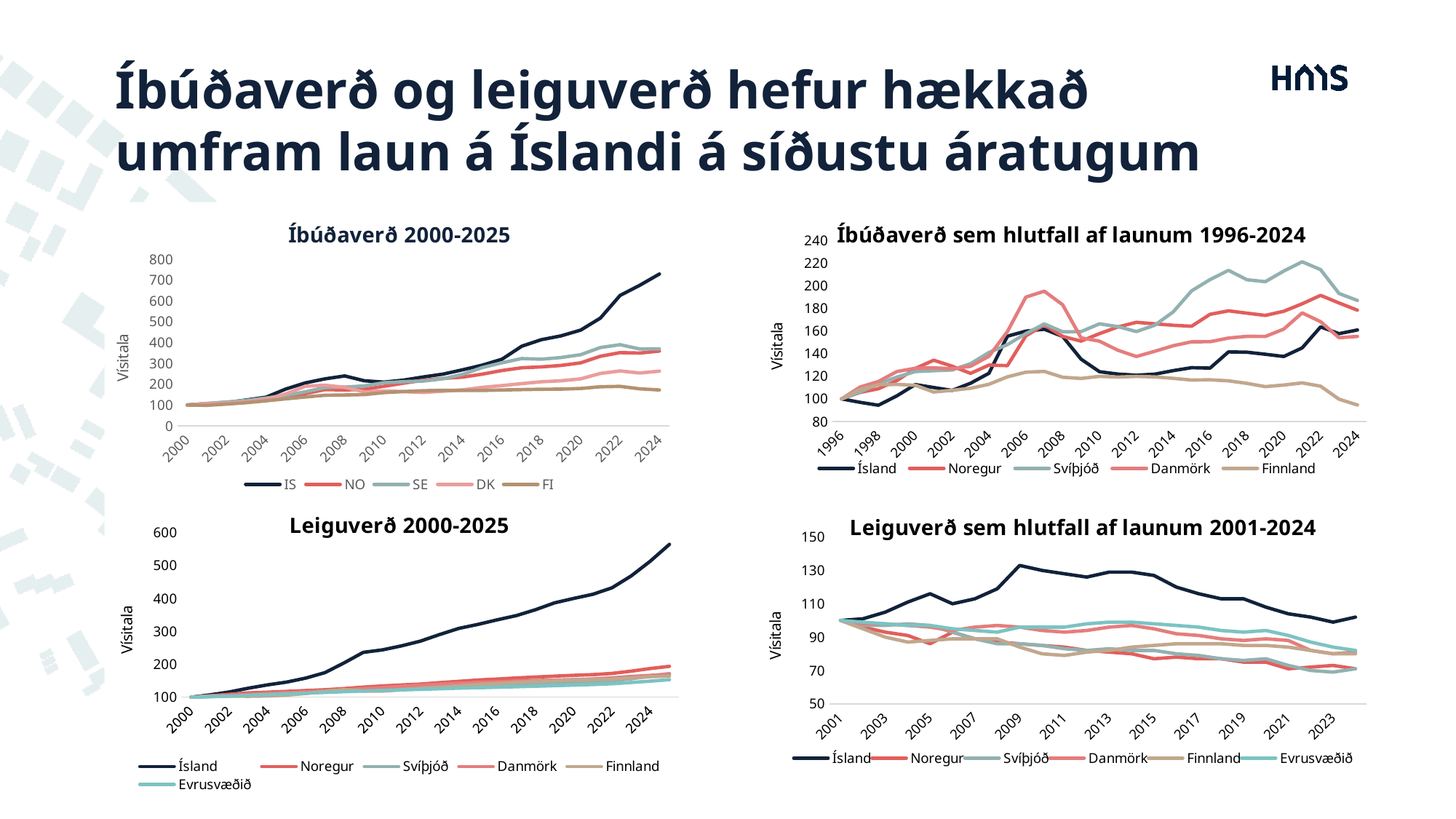
What kind of chart is the 'Íbúðaverð 2000-2025' chart? line chart In the 'Íbúðaverð 2000-2025' chart, which series has the highest value in 2024? IS How many series does the legend of the 'Íbúðaverð 2000-2025' chart list? 5 How many series does the legend of the 'Leiguverð 2000-2025' chart list? 6 In the 'Íbúðaverð sem hlutfall af launum 1996-2024' chart, which series has the lowest value in 2024? Finnland In the 'Leiguverð sem hlutfall af launum 2001-2024' chart, does the Ísland series rise or fall between 2009 and 2023? fall In the 'Íbúðaverð 2000-2025' chart, is the value for IS in 2024 greater or less than 600? greater In the 'Íbúðaverð 2000-2025' chart, is the value for FI in 2024 greater or less than 200? less In the 'Leiguverð 2000-2025' chart, which series is larger in 2024, Ísland or Noregur? Ísland In the 'Íbúðaverð sem hlutfall af launum 1996-2024' chart, is the value for Svíþjóð in 2022 greater or less than 200? greater What is the title of the chart in the bottom-right of the slide? Leiguverð sem hlutfall af launum 2001-2024